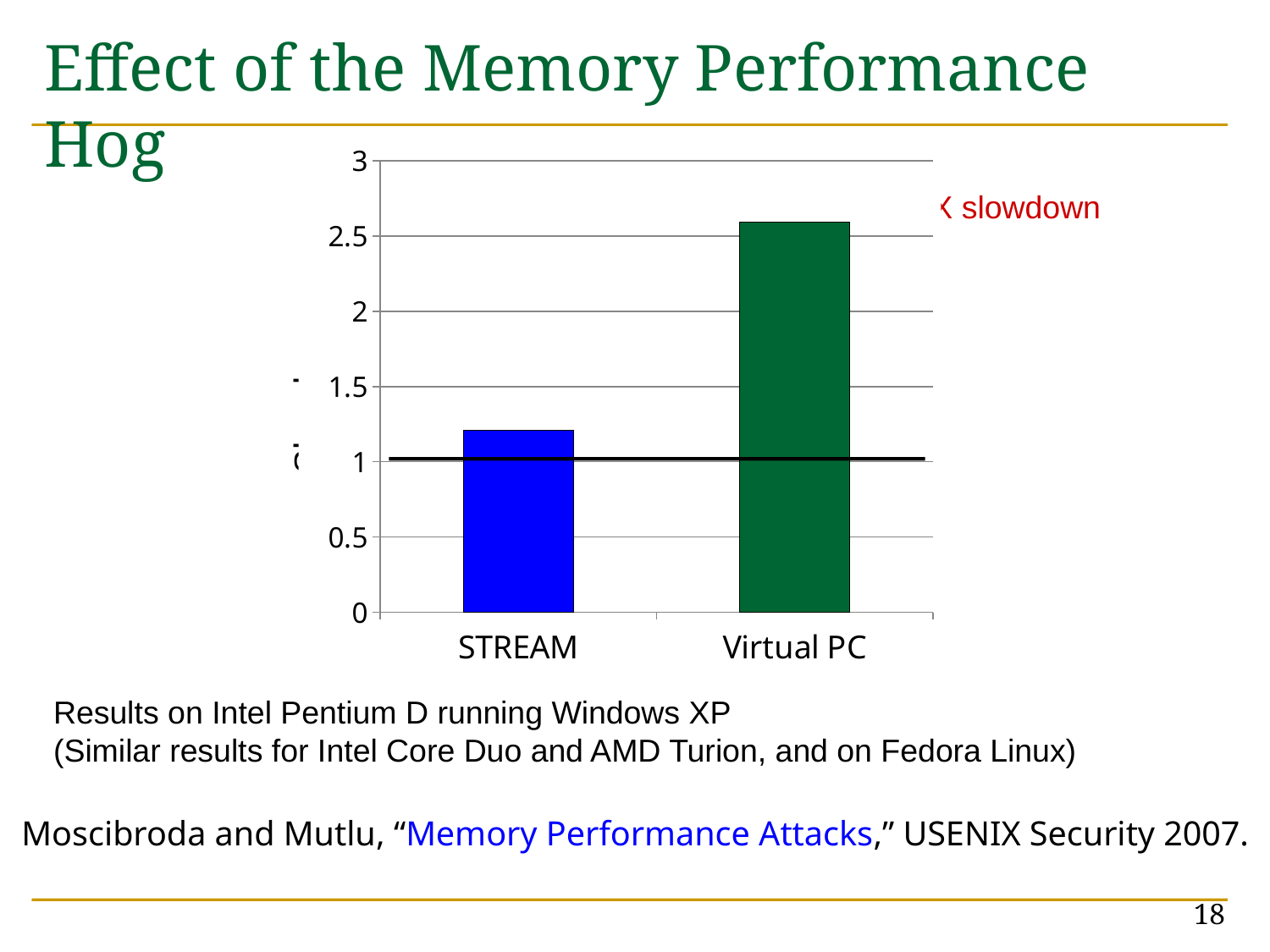
What is the highest tick value shown on the y axis of the chart? 3 Is the value for Virtual PC greater or less than 2? greater Which category has the highest bar in the chart? Virtual PC How many categories are plotted on the x axis of the chart? 2 Which category has the lowest bar in the chart? STREAM Is the value for STREAM greater or less than 1.5? less What kind of chart is shown on the slide? bar chart What colour is the bar for STREAM? blue Is the value for STREAM greater or less than 1? greater Which bar is taller, STREAM or Virtual PC? Virtual PC Do the bar values rise or fall from STREAM to Virtual PC? rise